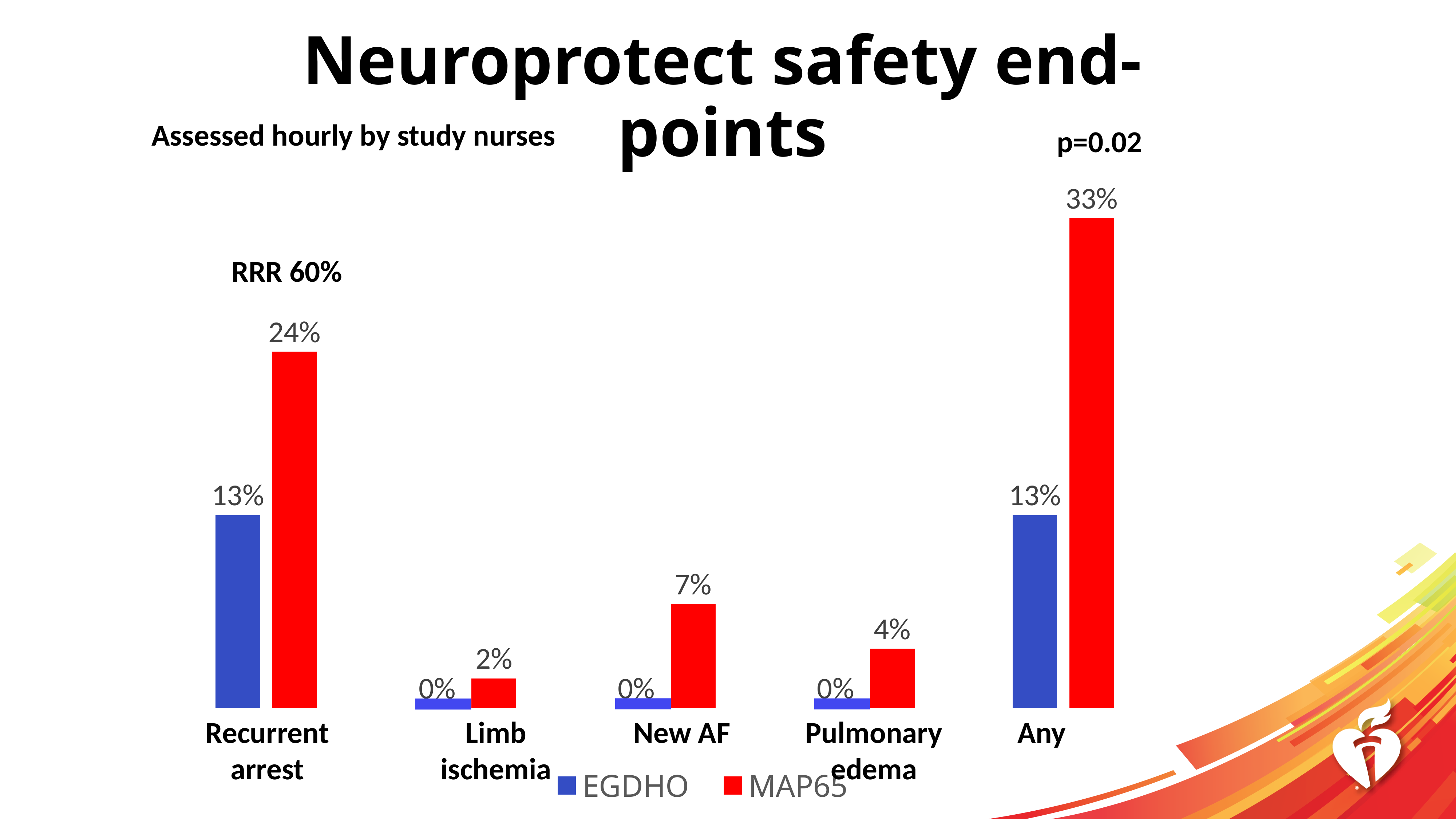
Which is larger for Pulmonary edema, the EGDHO value or the MAP65 value? MAP65 How many series does the legend list? 2 Which category has the lowest MAP65 value? Limb ischemia What is the difference between the MAP65 and EGDHO values for Recurrent arrest? 11% Which category has the highest MAP65 value? Any What is the EGDHO value for Pulmonary edema? 0% What kind of chart is shown on the slide? Bar chart What is the EGDHO value for Any? 13% How many categories are shown on the x axis? 5 What is the MAP65 value for Recurrent arrest? 24% What is the MAP65 value for New AF? 7% What is the difference between the MAP65 and EGDHO values for Any? 20%